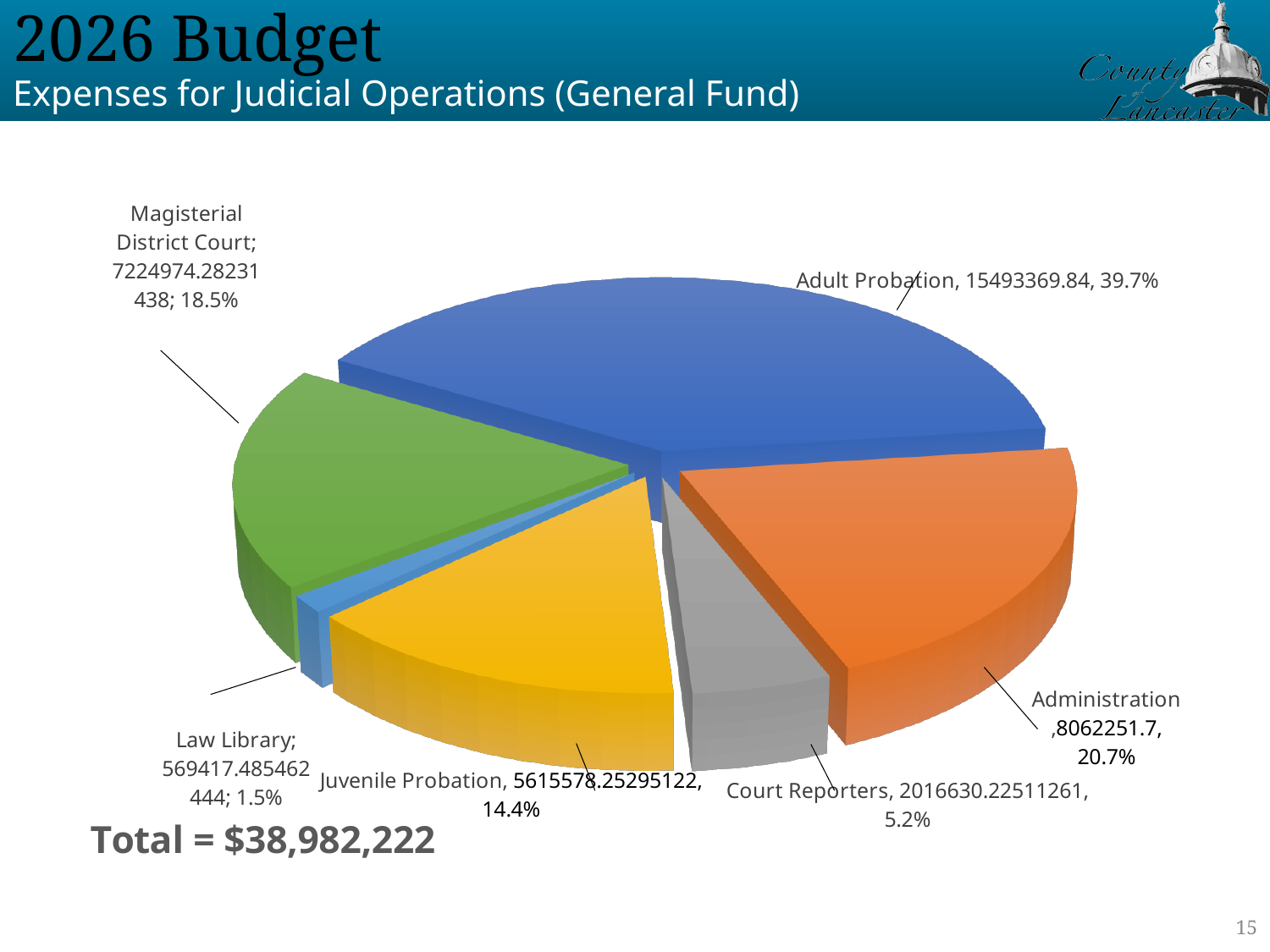
What percentage share does Adult Probation have? 39.7% What kind of chart is shown on the slide? pie chart How many slices does the pie chart have? 6 What percentage share does Court Reporters have? 5.2% What total is stated on the slide for the judicial operations expenses? $38,982,222 By how many percentage points does Adult Probation's share exceed Magisterial District Court's share? 21.2 Which has a larger share, Administration or Magisterial District Court? Administration Which category has the largest share of the pie? Adult Probation What percentage share does Administration have? 20.7% What is the value shown for Adult Probation? 15493369.84 Which category has the smallest share of the pie? Law Library